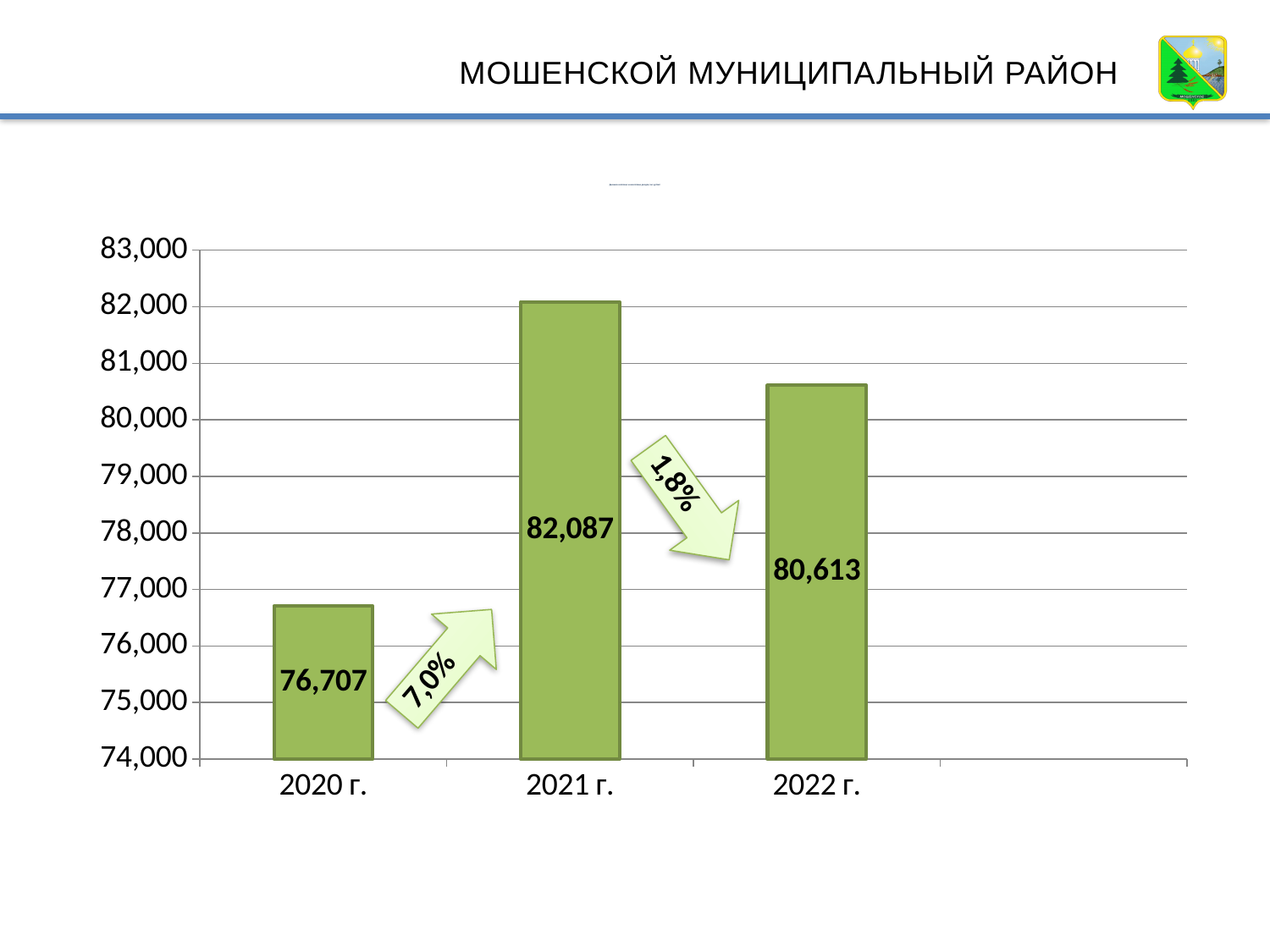
What percentage change is shown on the arrow between 2020 г. and 2021 г.? 7,0% What is the value for 2020 г.? 76,707 What is the value for 2021 г.? 82,087 What is the value for 2022 г.? 80,613 Which year has the highest value? 2021 г. Is the value for 2020 г. greater or less than 77,000? less Which is larger, the value for 2022 г. or the value for 2020 г.? 2022 г. What is the difference between the values for 2021 г. and 2020 г.? 5,380 Which year has the lowest value? 2020 г. How many bars are shown in the chart? 3 What kind of chart is shown on the slide? bar chart What is the difference between the values for 2021 г. and 2022 г.? 1,474